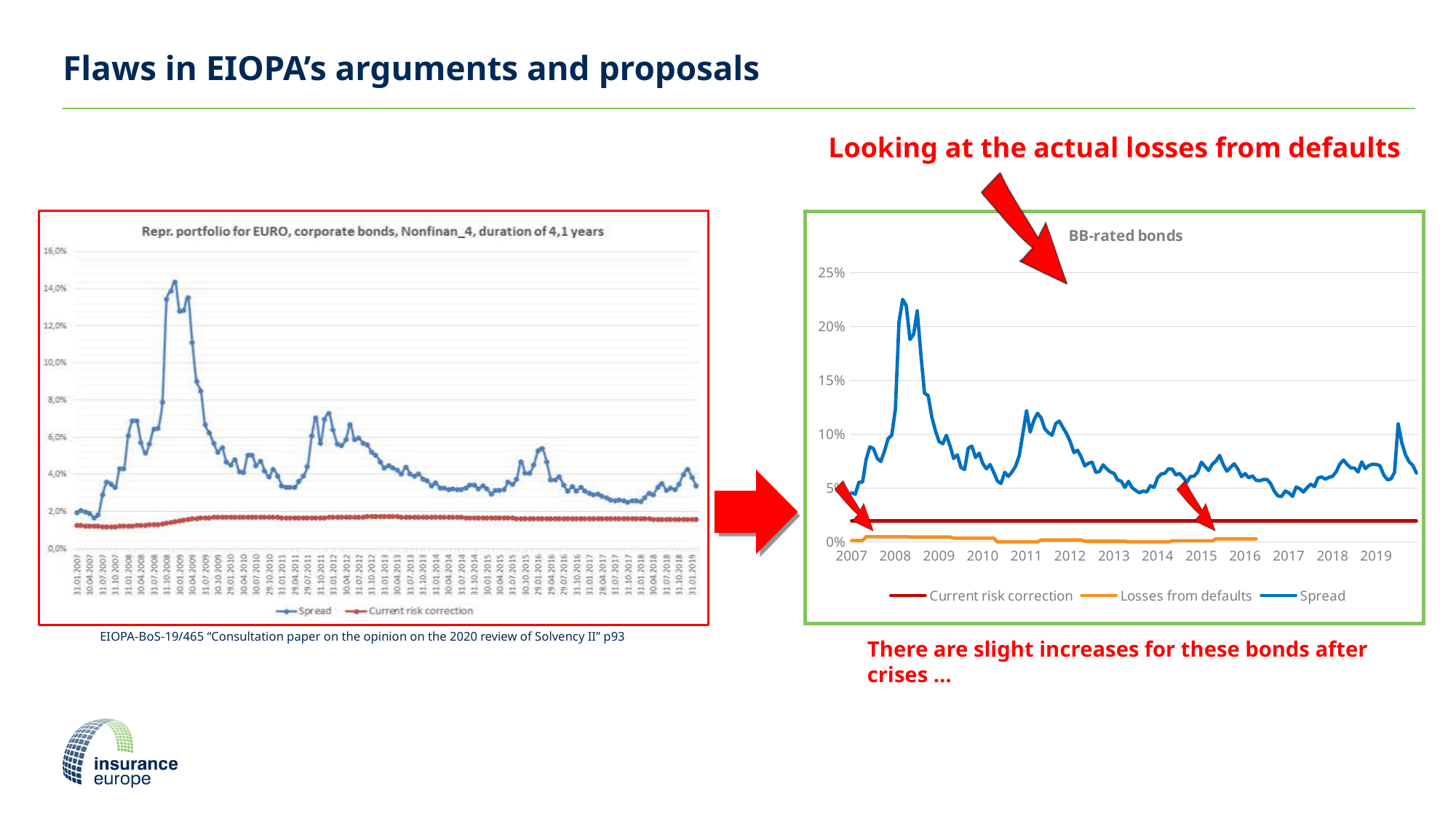
What is the title of the chart on the right side of the slide? BB-rated bonds What type of chart is the 'BB-rated bonds' chart on the right? line chart In the 'BB-rated bonds' chart, is the Current risk correction series greater or less than 5% throughout the period? less In the 'BB-rated bonds' chart, which series is shown in orange? Losses from defaults In the 'BB-rated bonds' chart, is the peak value of the Spread series in 2008 greater or less than 20%? greater In the left chart (Repr. portfolio for EURO), is the Current risk correction series greater or less than 4,0% throughout the period? less What type of chart is the left chart titled 'Repr. portfolio for EURO, corporate bonds, Nonfinan_4, duration of 4,1 years'? line chart How many series does the legend of the left chart (Repr. portfolio for EURO) list? 2 In the 'BB-rated bonds' chart, which series is higher in 2008: Spread or Losses from defaults? Spread How many series does the legend of the 'BB-rated bonds' chart list? 3